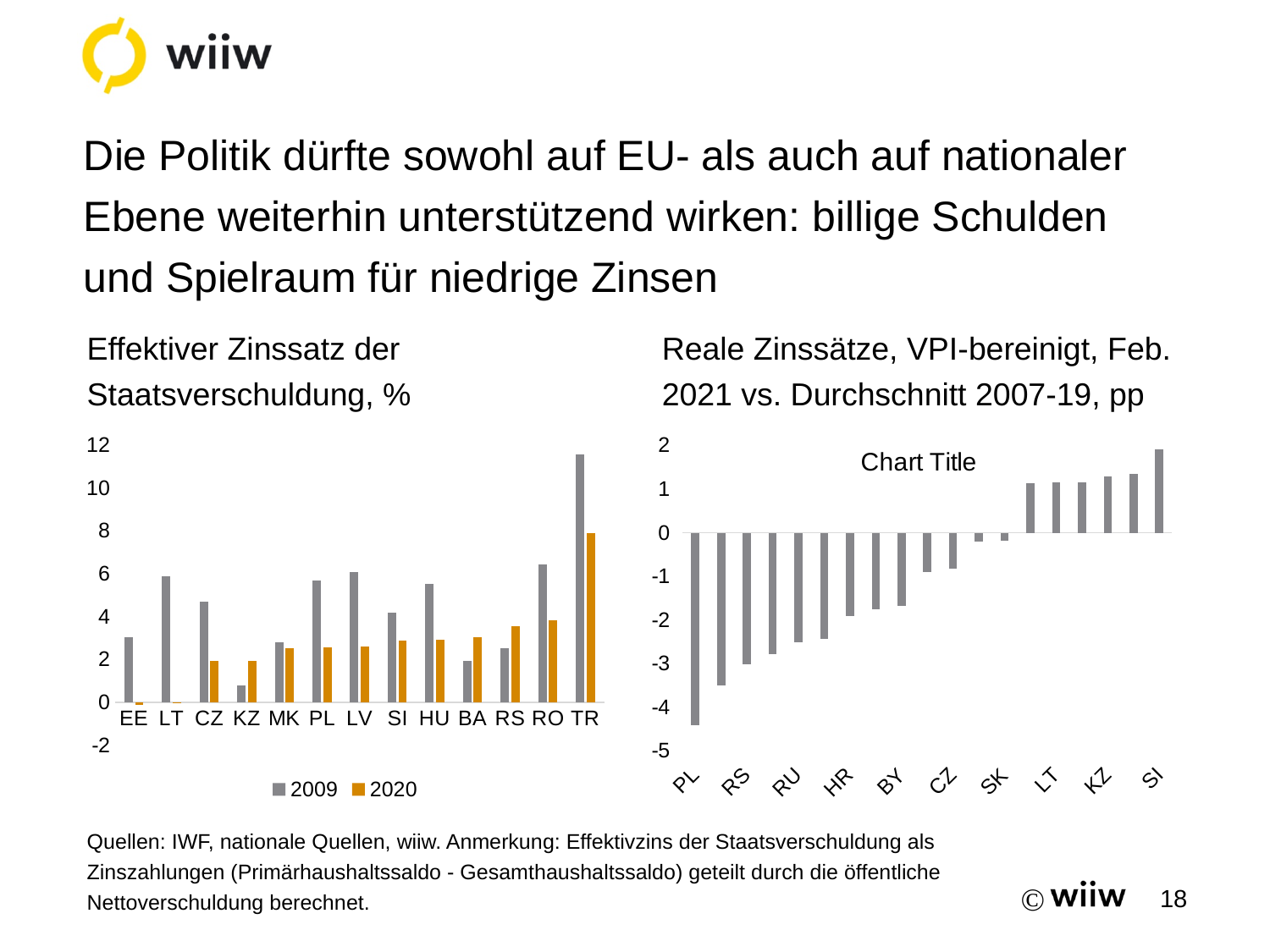
In the right chart, 'Reale Zinssätze, VPI-bereinigt, Feb. 2021 vs. Durchschnitt 2007-19, pp', do the values rise or fall from left to right along the x axis? rise In the left chart, 'Effektiver Zinssatz der Staatsverschuldung, %', which is larger for EE: the 2009 value or the 2020 value? 2009 In the left chart, 'Effektiver Zinssatz der Staatsverschuldung, %', which is larger for RS: the 2009 value or the 2020 value? 2020 In the left chart, 'Effektiver Zinssatz der Staatsverschuldung, %', which country has the highest value for 2009? TR How many countries are shown on the x axis of the left chart, 'Effektiver Zinssatz der Staatsverschuldung, %'? 13 What kind of chart is the left chart, 'Effektiver Zinssatz der Staatsverschuldung, %'? bar chart In the right chart, 'Reale Zinssätze, VPI-bereinigt, Feb. 2021 vs. Durchschnitt 2007-19, pp', which country has the lowest value? PL In the left chart, 'Effektiver Zinssatz der Staatsverschuldung, %', is the 2009 value for TR greater or less than 10? greater In the left chart, 'Effektiver Zinssatz der Staatsverschuldung, %', which country has the highest value for 2020? TR How many series does the legend of the left chart, 'Effektiver Zinssatz der Staatsverschuldung, %', list? 2 In the right chart, 'Reale Zinssätze, VPI-bereinigt, Feb. 2021 vs. Durchschnitt 2007-19, pp', which country has the highest value? SI